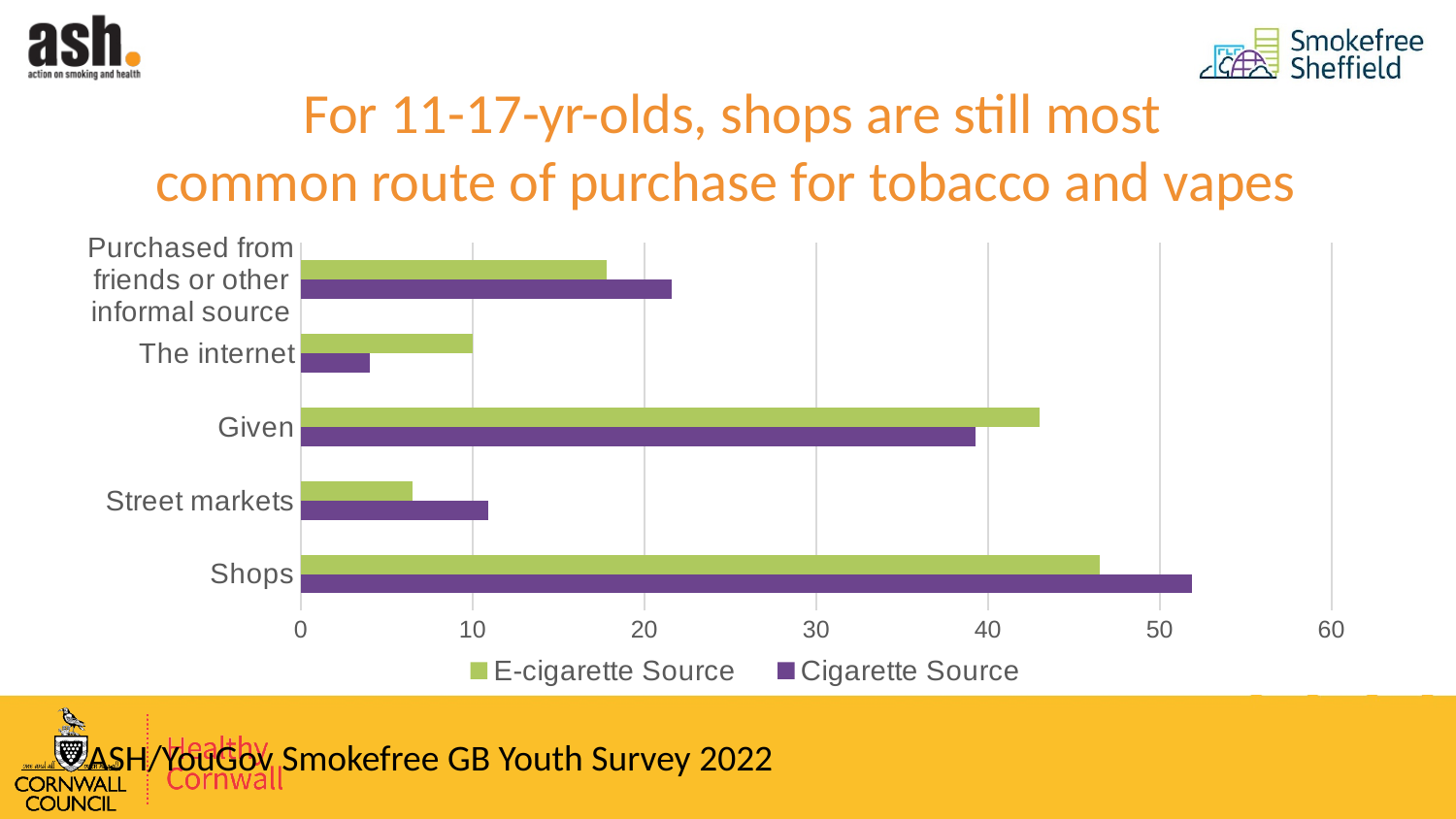
Which category has the highest value for Cigarette Source? Shops For The internet, which series has the larger value, E-cigarette Source or Cigarette Source? E-cigarette Source How many series does the chart legend list? 2 Which colour represents the E-cigarette Source series in the chart? green Which category has the lowest value for Cigarette Source? The internet What kind of chart is shown on the slide? bar chart For Shops, which series has the larger value, E-cigarette Source or Cigarette Source? Cigarette Source How many purchase-route categories are shown on the chart? 5 Is the Cigarette Source value for Shops greater or less than 50? greater Which category has the lowest value for E-cigarette Source? Street markets Is the Cigarette Source value for The internet greater or less than 10? less Is the E-cigarette Source value for Given greater or less than 40? greater